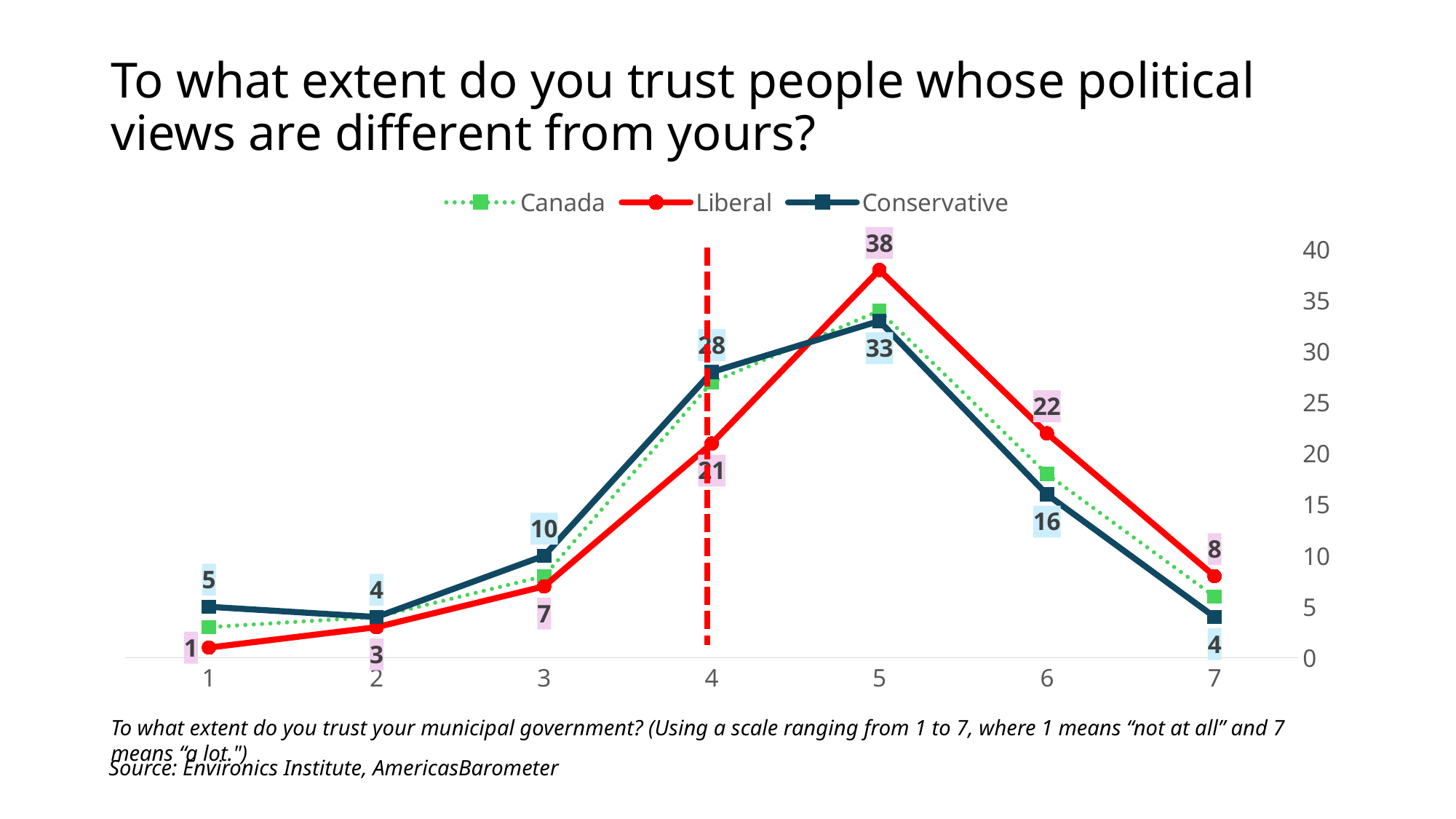
Is the Canada value at scale point 5 greater or less than 30? greater How many series does the legend list? 3 At which scale point is the Liberal series lowest? 1 At scale point 4, which series has the larger value, Liberal or Conservative? Conservative What is the Conservative value at scale point 6? 16 What is the Conservative value at scale point 4? 28 What kind of chart is shown on the slide? Line chart Does the Conservative series rise or fall from scale point 5 to scale point 7? Fall What is the Liberal value at scale point 1? 1 What is the Liberal value at scale point 5? 38 At which scale point does the Liberal series reach its highest value? 5 What is the difference between the Liberal and Conservative values at scale point 5? 5